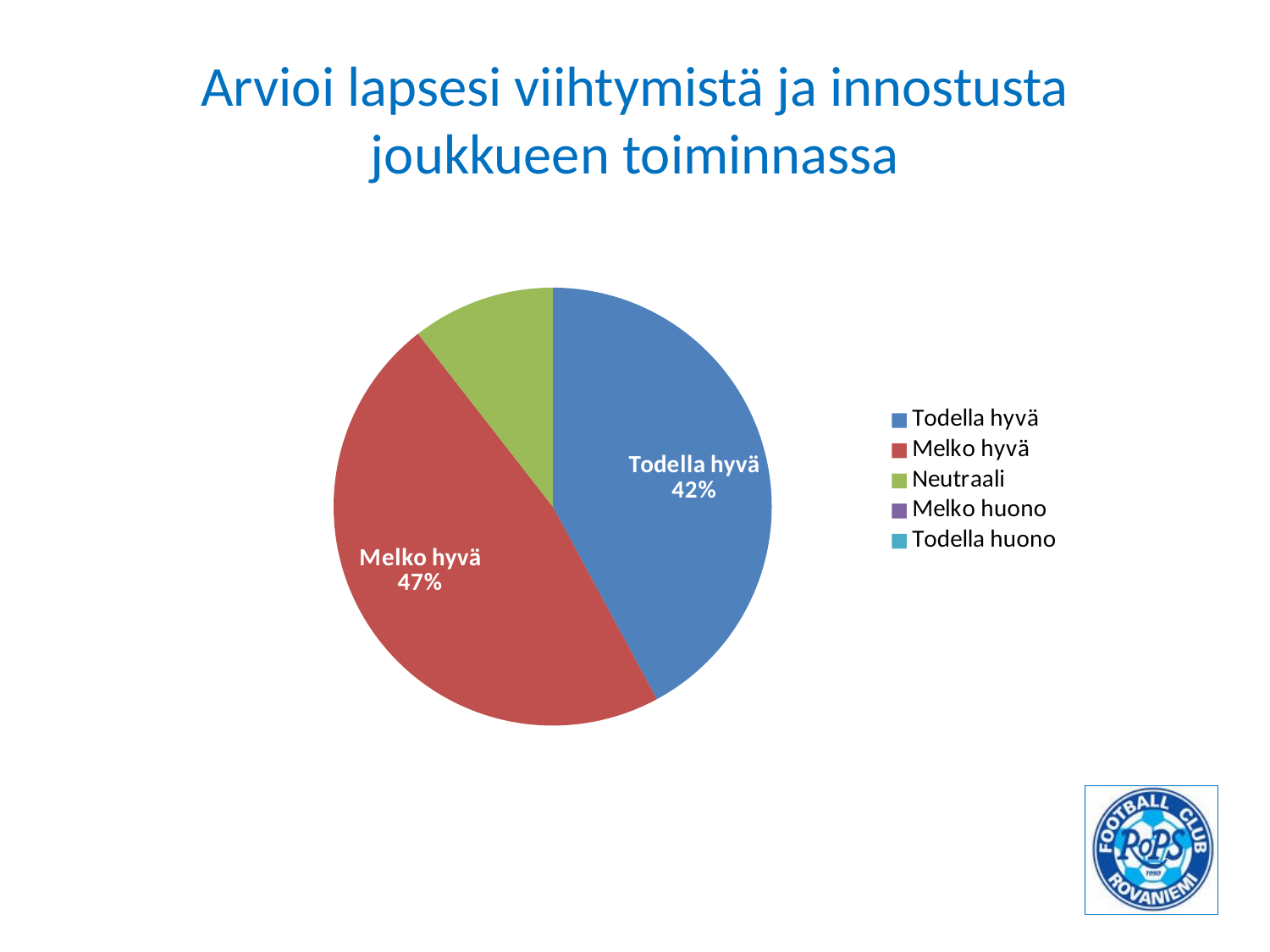
What colour is the Melko hyvä slice? Red How many entries does the legend list? 5 Which slice is larger, Todella hyvä or Melko hyvä? Melko hyvä Of the slices drawn in the pie, which one is the smallest? Neutraali What is the difference in percentage points between the Melko hyvä slice and the Todella hyvä slice? 5% What percentage of the pie is labelled Todella hyvä? 42% What percentage of the pie is labelled Melko hyvä? 47% What is the title of the slide? Arvioi lapsesi viihtymistä ja innostusta joukkueen toiminnassa What kind of chart is shown on the slide? Pie chart How many slices are visibly drawn in the pie? 3 Which category has the largest slice of the pie? Melko hyvä